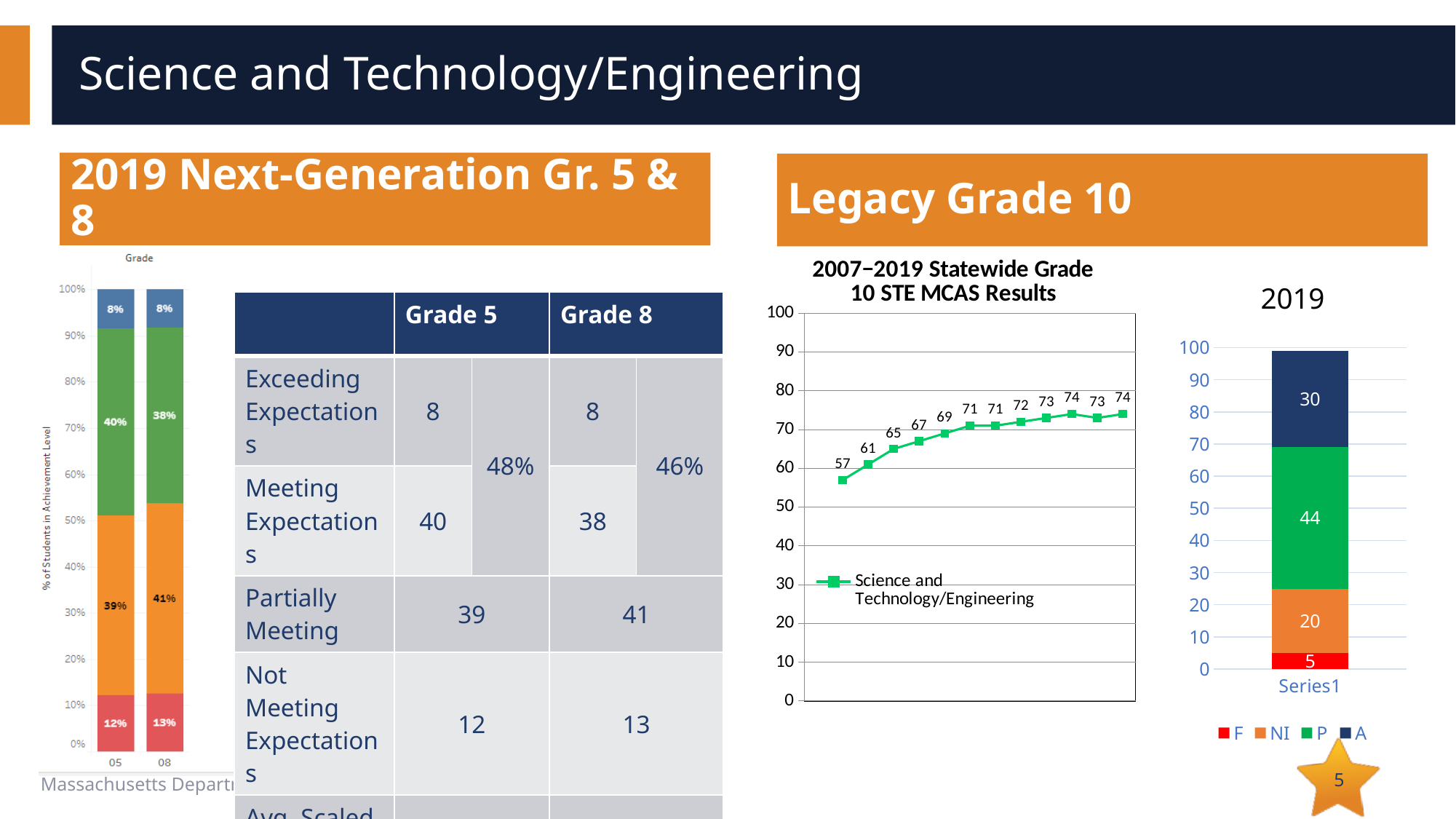
In the line chart titled '2007–2019 Statewide Grade 10 STE MCAS Results', what is the first (leftmost) value? 57 In the 2019 stacked bar chart on the right, which segment is the largest? P In the line chart titled '2007–2019 Statewide Grade 10 STE MCAS Results', do the values generally rise or fall from left to right? rise In the 2019 stacked bar chart on the right, which segment is the smallest? F In the 2019 stacked bar chart on the right, what is the value for F? 5 In the line chart titled '2007–2019 Statewide Grade 10 STE MCAS Results', what is the lowest value plotted? 57 How many series does the legend of the 2019 stacked bar chart on the right list? 4 In the 2019 stacked bar chart on the right, what is the difference between the A and NI values? 10 In the 2019 stacked bar chart on the right, what is the value for P? 44 In the stacked bar chart on the left of the slide, which grade has the larger red (bottom) segment, 05 or 08? 08 What type of chart is the '2007–2019 Statewide Grade 10 STE MCAS Results' chart? line chart In the stacked bar chart on the left of the slide, what is the green segment value for grade 08? 38%